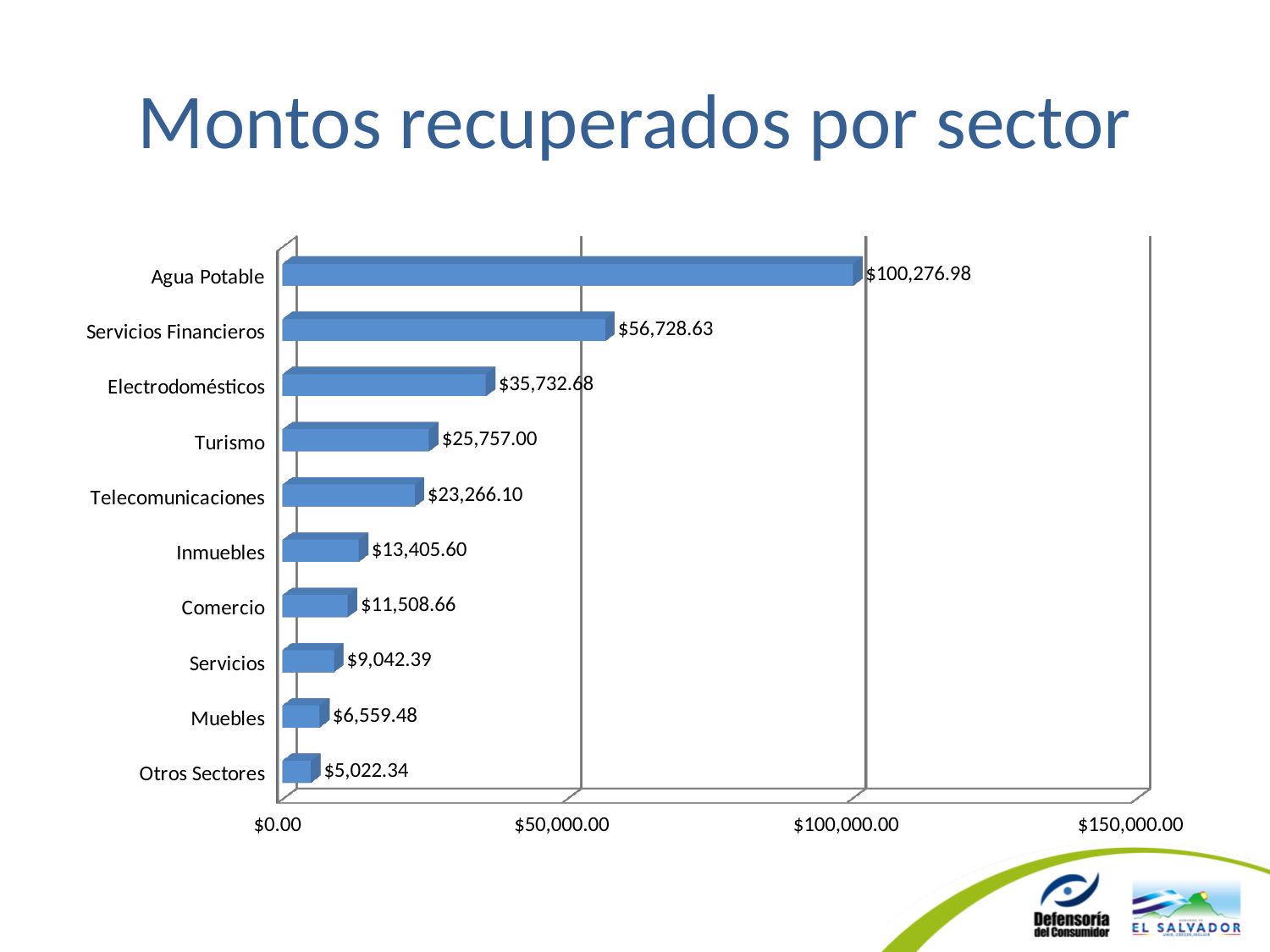
Which sector has the lowest recovered amount? Otros Sectores What is the title of the chart? Montos recuperados por sector Which is larger, the value for Electrodomésticos or the value for Inmuebles? Electrodomésticos What is the difference between the values for Turismo and Telecomunicaciones? $2,490.90 What kind of chart is shown on the slide? Bar chart How many sectors are shown in the chart? 10 Is the value for Servicios Financieros greater or less than $50,000.00? greater Which sector has the highest recovered amount? Agua Potable What is the value for Agua Potable? $100,276.98 What is the difference between the values for Agua Potable and Servicios Financieros? $43,548.35 What is the value for Telecomunicaciones? $23,266.10 What is the value for Muebles? $6,559.48